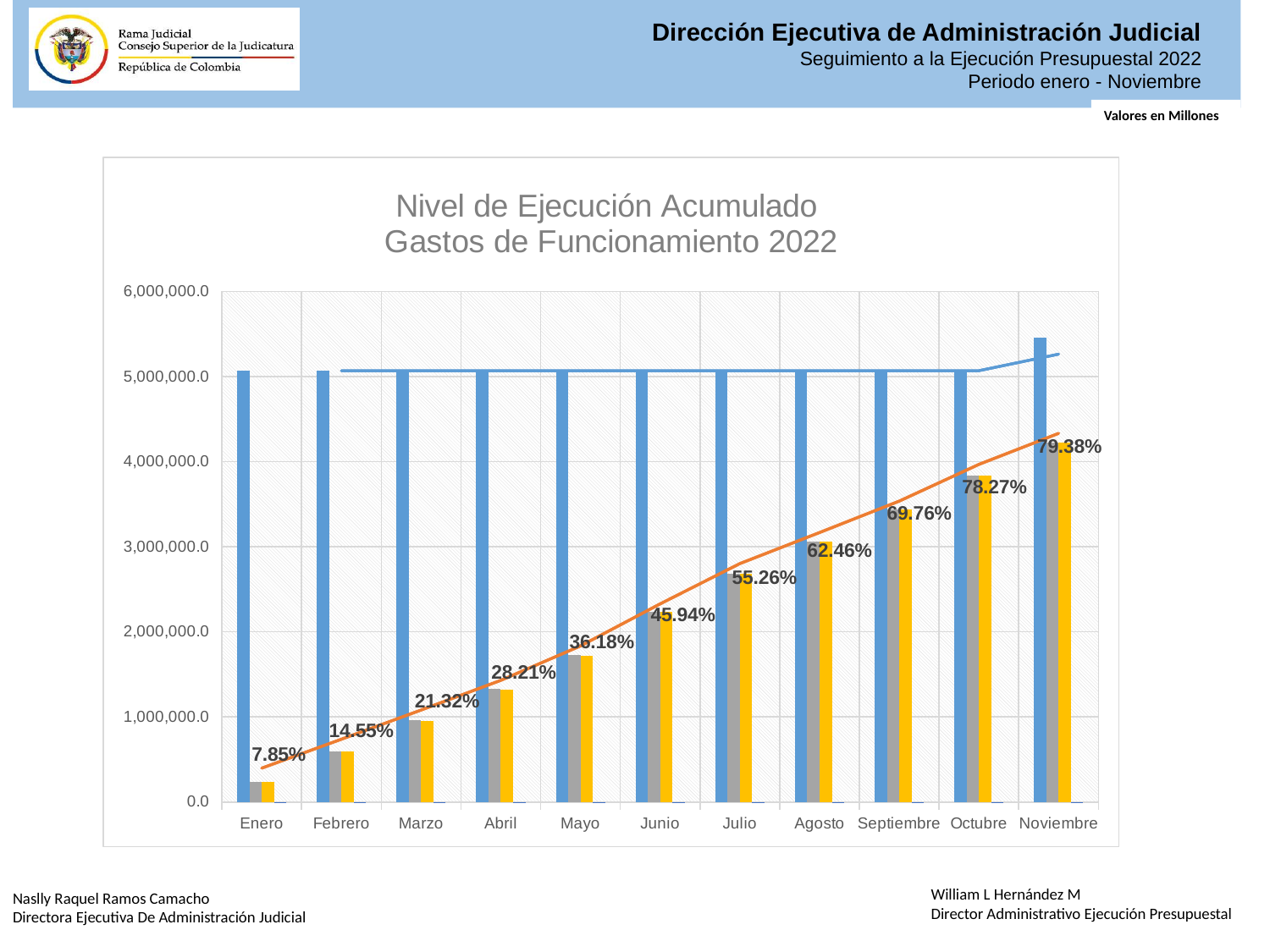
What is the percentage label shown for Enero? 7.85% Which month has the highest percentage label? Noviembre What is the difference between the percentage labels for Noviembre and Octubre? 1.11% What is the percentage label shown for Noviembre? 79.38% Which month has the lowest percentage label? Enero What is the difference between the percentage labels for Julio and Junio? 9.32% Which has a larger percentage label, Agosto or Septiembre? Septiembre How many months are shown on the x axis? 11 Is the value of the tall blue bar for Enero greater or less than 4,000,000.0? greater What is the percentage label shown for Junio? 45.94% Do the percentage labels rise or fall from Enero to Noviembre? rise Is the value of the yellow bar for Noviembre greater or less than 5,000,000.0? less